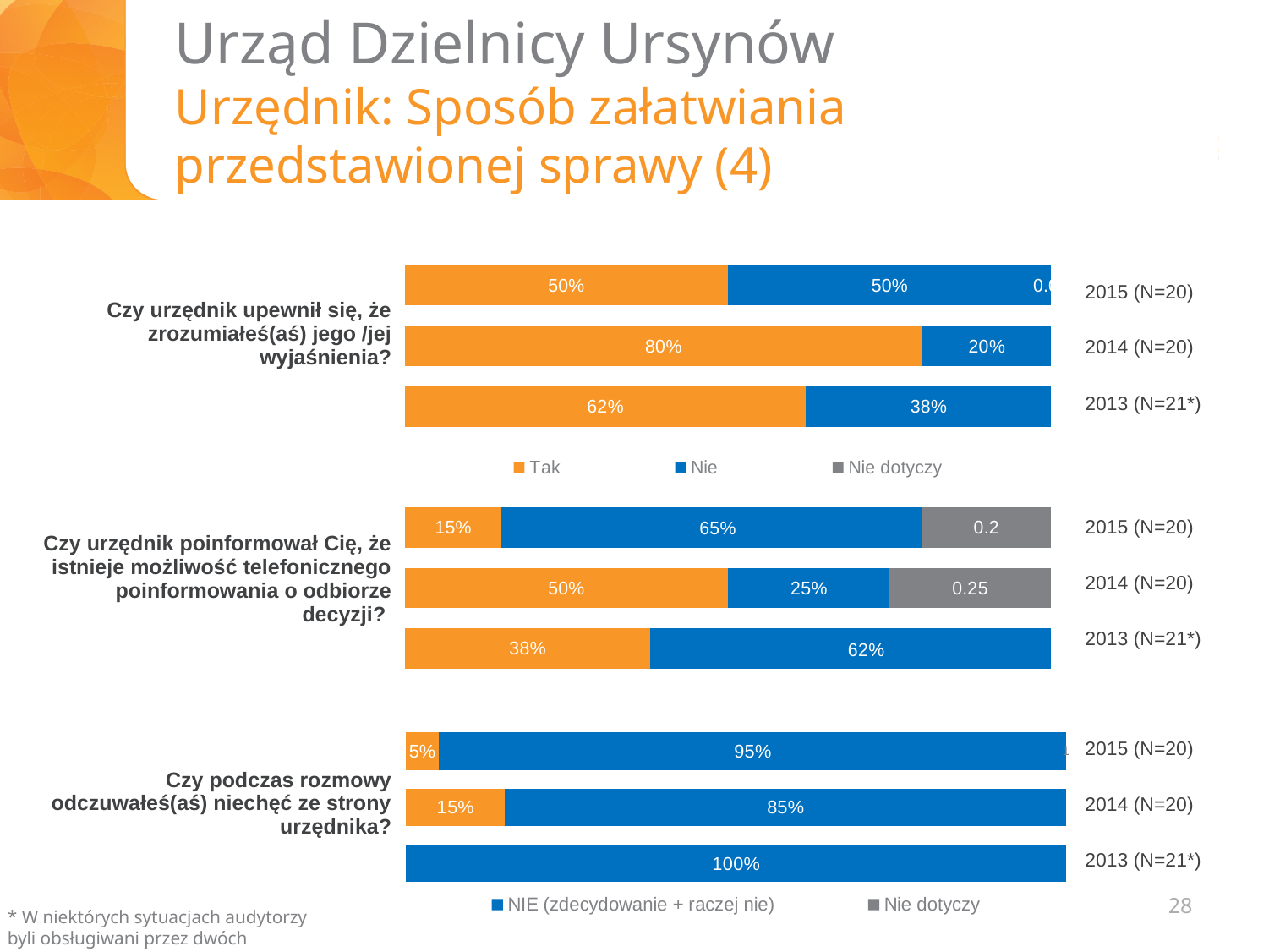
In the chart for "Czy urzędnik poinformował Cię, że istnieje możliwość telefonicznego poinformowania o odbiorze decyzji?", what is the "Nie" value for 2015 (N=20)? 65% In the chart for "Czy urzędnik poinformował Cię, że istnieje możliwość telefonicznego poinformowania o odbiorze decyzji?", is the "Tak" value for 2014 (N=20) larger or smaller than the "Tak" value for 2013 (N=21*)? larger In the chart for "Czy urzędnik upewnił się, że zrozumiałeś(aś) jego /jej wyjaśnienia?", which year has the highest "Tak" value? 2014 (N=20) In the chart for "Czy urzędnik poinformował Cię, że istnieje możliwość telefonicznego poinformowania o odbiorze decyzji?", what is the "Nie dotyczy" value for 2014 (N=20)? 0.25 In the chart for "Czy urzędnik upewnił się, że zrozumiałeś(aś) jego /jej wyjaśnienia?", what is the "Tak" value for 2014 (N=20)? 80% In the chart for "Czy urzędnik upewnił się, że zrozumiałeś(aś) jego /jej wyjaśnienia?", what is the difference between the "Tak" values for 2014 (N=20) and 2015 (N=20)? 30% In the chart for "Czy podczas rozmowy odczuwałeś(aś) niechęć ze strony urzędnika?", what is the "NIE (zdecydowanie + raczej nie)" value for 2015 (N=20)? 95% How many entries does the legend list for the chart "Czy urzędnik upewnił się, że zrozumiałeś(aś) jego /jej wyjaśnienia?"? 3 In the chart for "Czy urzędnik upewnił się, że zrozumiałeś(aś) jego /jej wyjaśnienia?", what is the "Nie" value for 2013 (N=21*)? 38% In the chart for "Czy urzędnik poinformował Cię, że istnieje możliwość telefonicznego poinformowania o odbiorze decyzji?", which year has the lowest "Tak" value? 2015 (N=20) What kind of chart is used for "Czy podczas rozmowy odczuwałeś(aś) niechęć ze strony urzędnika?"? Stacked bar chart In the chart for "Czy podczas rozmowy odczuwałeś(aś) niechęć ze strony urzędnika?", what is the value shown for 2013 (N=21*)? 100%